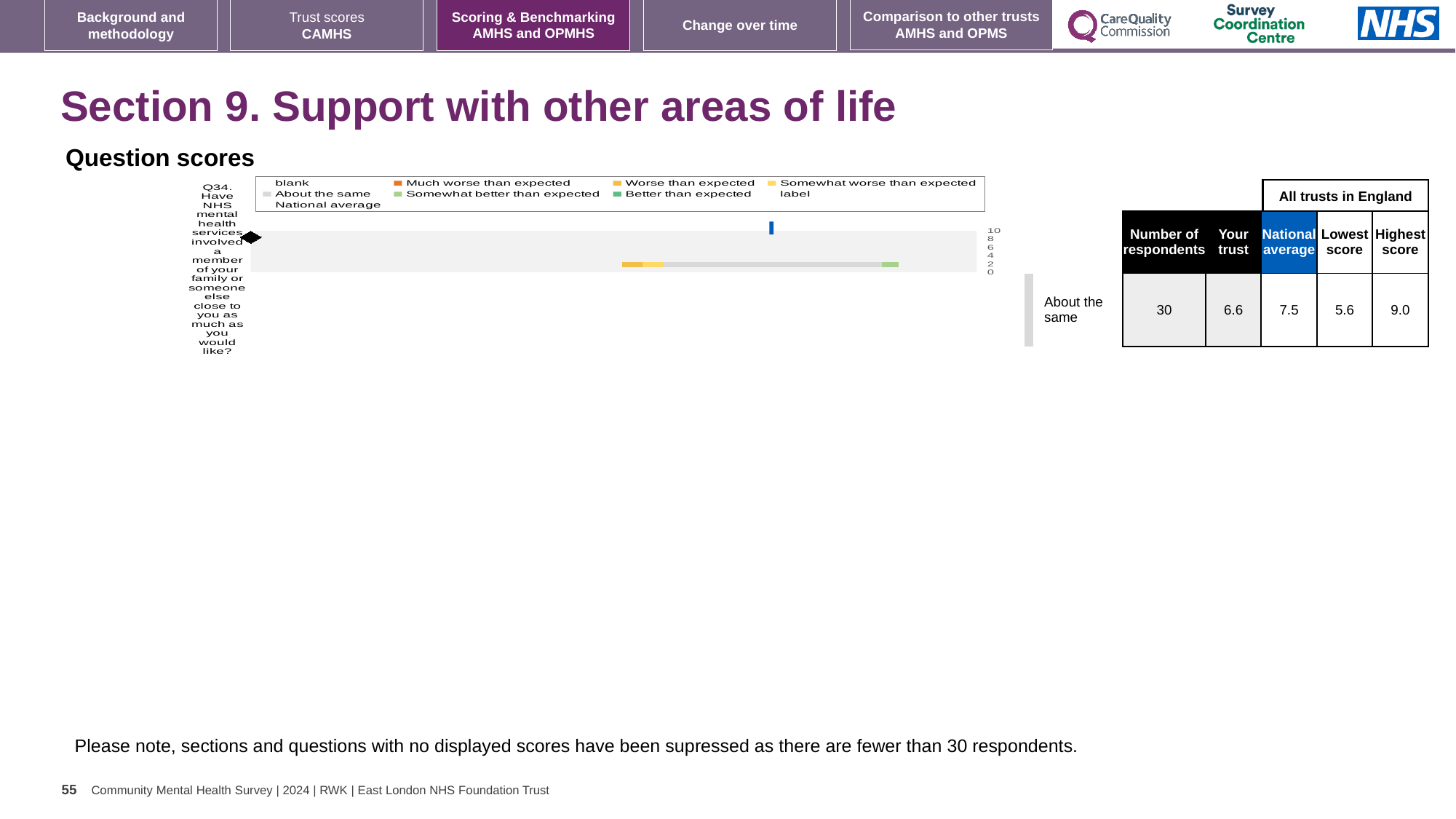
What is the lowest score among all trusts in England for Q34? 5.6 What is the 'Your trust' score for Q34? 6.6 What is the national average score for Q34? 7.5 What is the highest score among all trusts in England for Q34? 9.0 What is the difference between the national average and the trust's score for Q34? 0.9 How many questions (categories) are plotted in the Question scores chart? 1 Which is larger for Q34, the trust's score or the national average? national average How many respondents answered Q34? 30 What is the highest value shown on the score axis of the Question scores chart? 10 Which question is plotted in the Question scores chart? Q34. Have NHS mental health services involved a member of your family or someone else close to you as much as you would like? Is the trust's score for Q34 greater or less than 4 on the chart's axis? greater What kind of chart is used to show the Q34 question score? bar chart